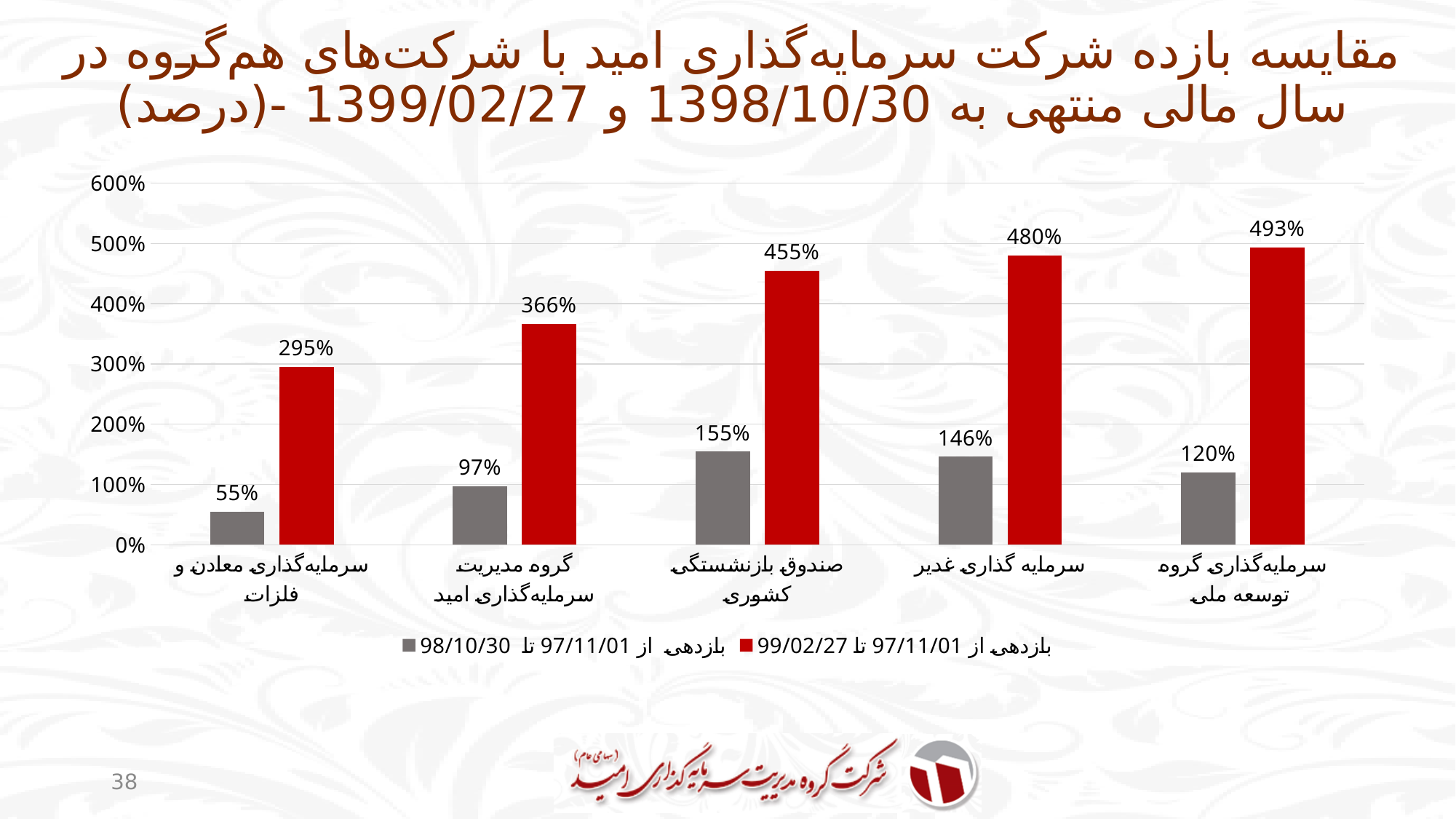
Which colour represents the series بازدهی از 97/11/01 تا 99/02/27 in the legend? red Which company has the lowest value in the gray series (بازدهی از 97/11/01 تا 98/10/30)? سرمایه‌گذاری معادن و فلزات How many series does the legend list? 2 What is the value of the red series for صندوق بازنشستگی کشوری? 455% What is the value of the gray series (بازدهی از 97/11/01 تا 98/10/30) for گروه مدیریت سرمایه‌گذاری امید? 97% Which is larger: the gray value for صندوق بازنشستگی کشوری or the gray value for سرمایه گذاری غدیر? صندوق بازنشستگی کشوری What type of chart is shown on the slide? bar chart Which company has the highest value in the red series (بازدهی از 97/11/01 تا 99/02/27)? سرمایه‌گذاری گروه توسعه ملی Is the red value for سرمایه‌گذاری معادن و فلزات greater or less than 300%? less What is the difference between the red and gray values for سرمایه گذاری غدیر? 334% What is the value of the red series (بازدهی از 97/11/01 تا 99/02/27) for سرمایه‌گذاری گروه توسعه ملی? 493% How many companies (categories) are shown on the x axis? 5